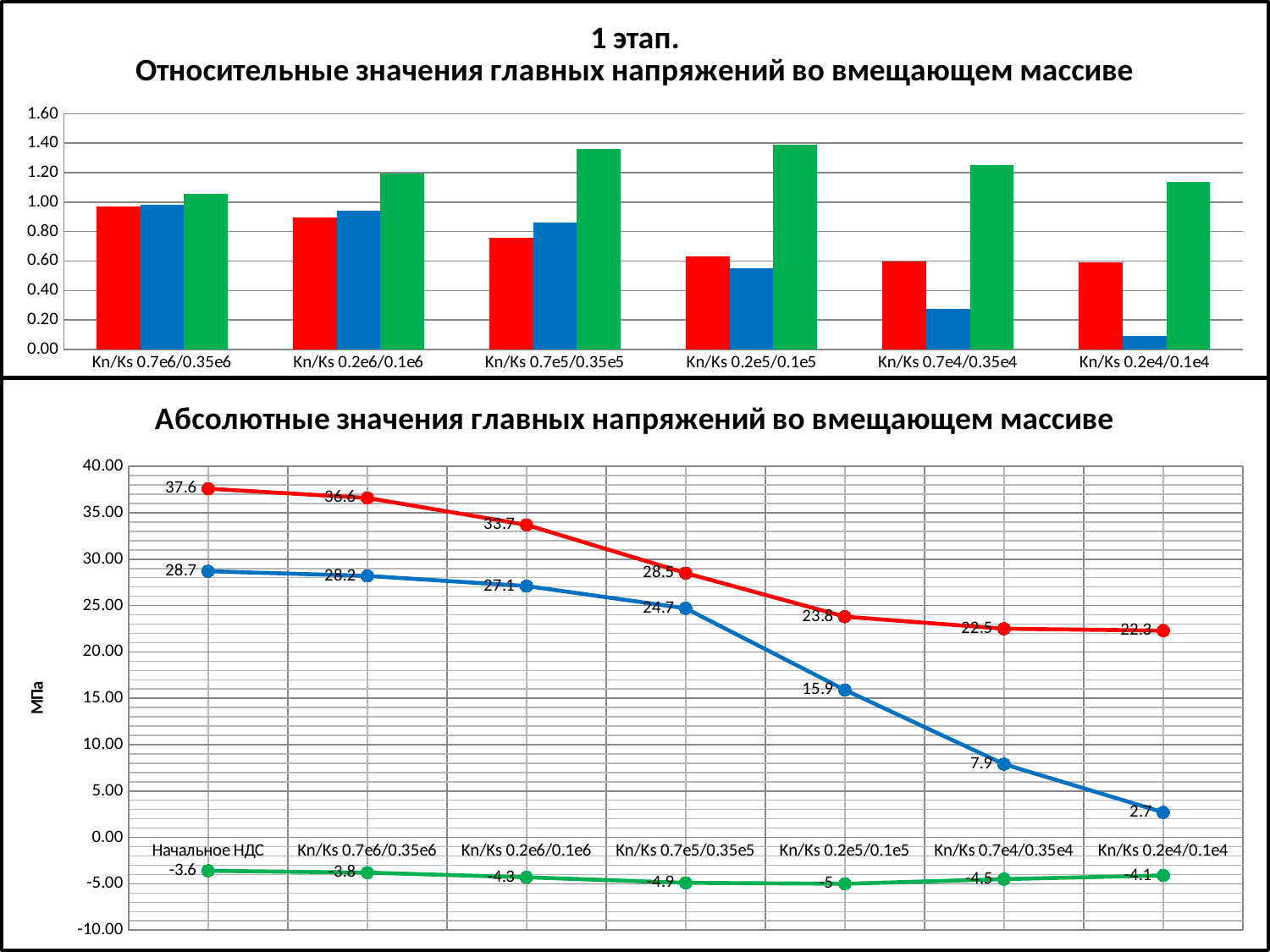
What kind of chart is the top chart titled "Относительные значения главных напряжений во вмещающем массиве"? bar chart In the bottom line chart, what is the difference between the red line values at Начальное НДС (37.6) and Kn/Ks 0.2e4/0.1e4 (22.3)? 15.3 In the bottom line chart, does the blue line rise or fall from left to right along the x axis? fall In the top bar chart, is the blue bar for Kn/Ks 0.2e4/0.1e4 greater or less than 0.20? less In the top bar chart, which is larger for Kn/Ks 0.7e4/0.35e4: the red bar or the blue bar? red bar How many data points does each line have in the bottom line chart? 7 How many categories are shown on the x axis of the top bar chart? 6 In the bottom line chart, what is the value of the red line at Начальное НДС? 37.6 In the top bar chart, is the green bar for Kn/Ks 0.2e5/0.1e5 greater or less than 1.20? greater What kind of chart is the bottom chart titled "Абсолютные значения главных напряжений во вмещающем массиве"? line chart In the bottom line chart, what is the value of the blue line at Kn/Ks 0.2e5/0.1e5? 15.9 In the bottom line chart, what is the value of the green line at Kn/Ks 0.7e5/0.35e5? -4.9